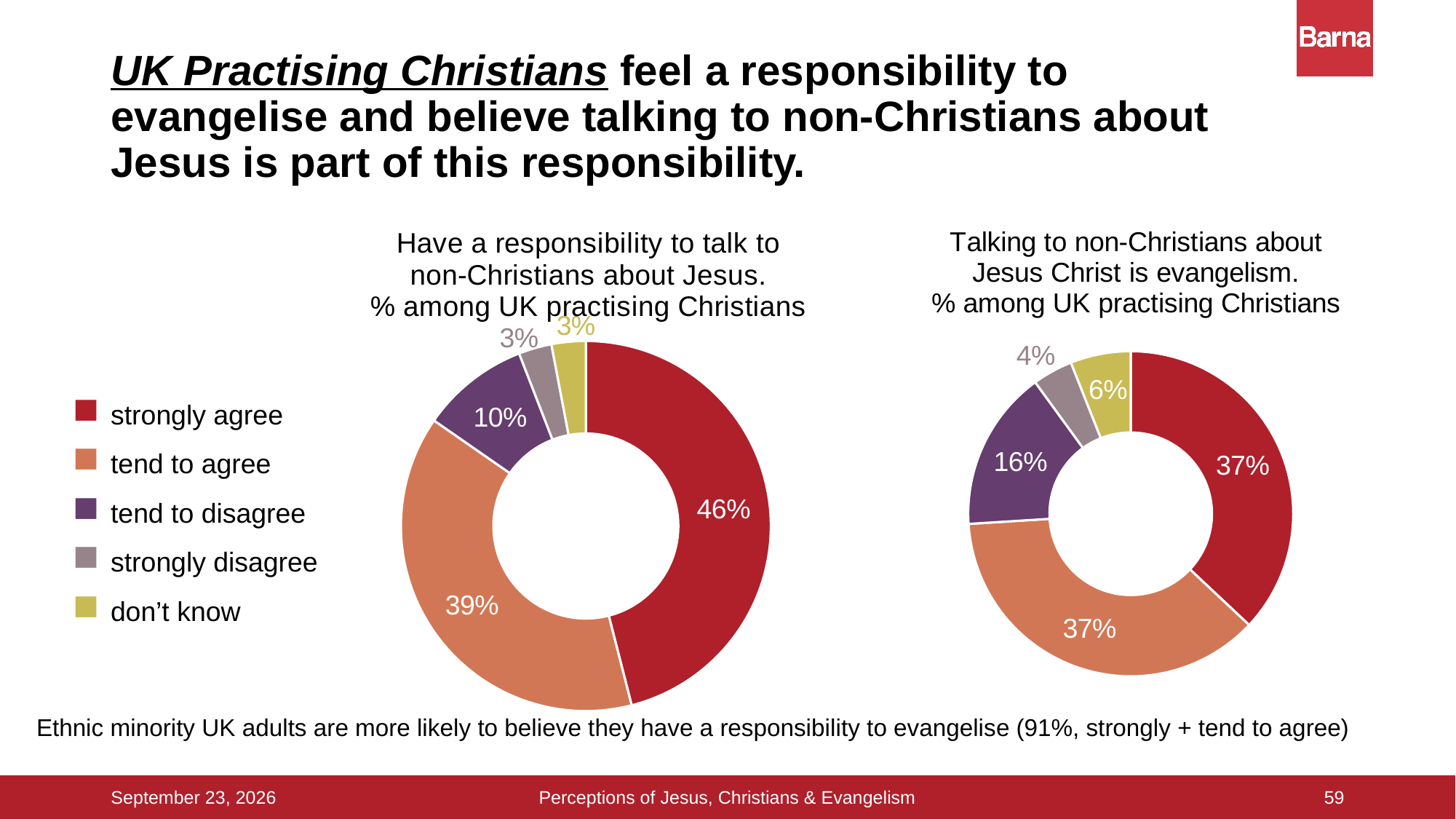
In the right chart ('Talking to non-Christians about Jesus Christ is evangelism'), what percentage answered don't know? 6% In the right chart ('Talking to non-Christians about Jesus Christ is evangelism'), which is larger: tend to disagree or don't know? tend to disagree In the right chart ('Talking to non-Christians about Jesus Christ is evangelism'), which response has the smallest share? strongly disagree In the left chart ('Have a responsibility to talk to non-Christians about Jesus'), what percentage strongly agree? 46% In the left chart ('Have a responsibility to talk to non-Christians about Jesus'), what percentage tend to disagree? 10% In the left chart ('Have a responsibility to talk to non-Christians about Jesus'), what percentage tend to agree? 39% How many response categories does the legend list? 5 What type of chart is used on this slide? Doughnut (pie) chart In the left chart ('Have a responsibility to talk to non-Christians about Jesus'), which response has the largest share? strongly agree In the left chart ('Have a responsibility to talk to non-Christians about Jesus'), what is the difference between the strongly agree and tend to agree percentages? 7% In the right chart ('Talking to non-Christians about Jesus Christ is evangelism'), what percentage strongly disagree? 4% In the right chart ('Talking to non-Christians about Jesus Christ is evangelism'), what percentage tend to disagree? 16%